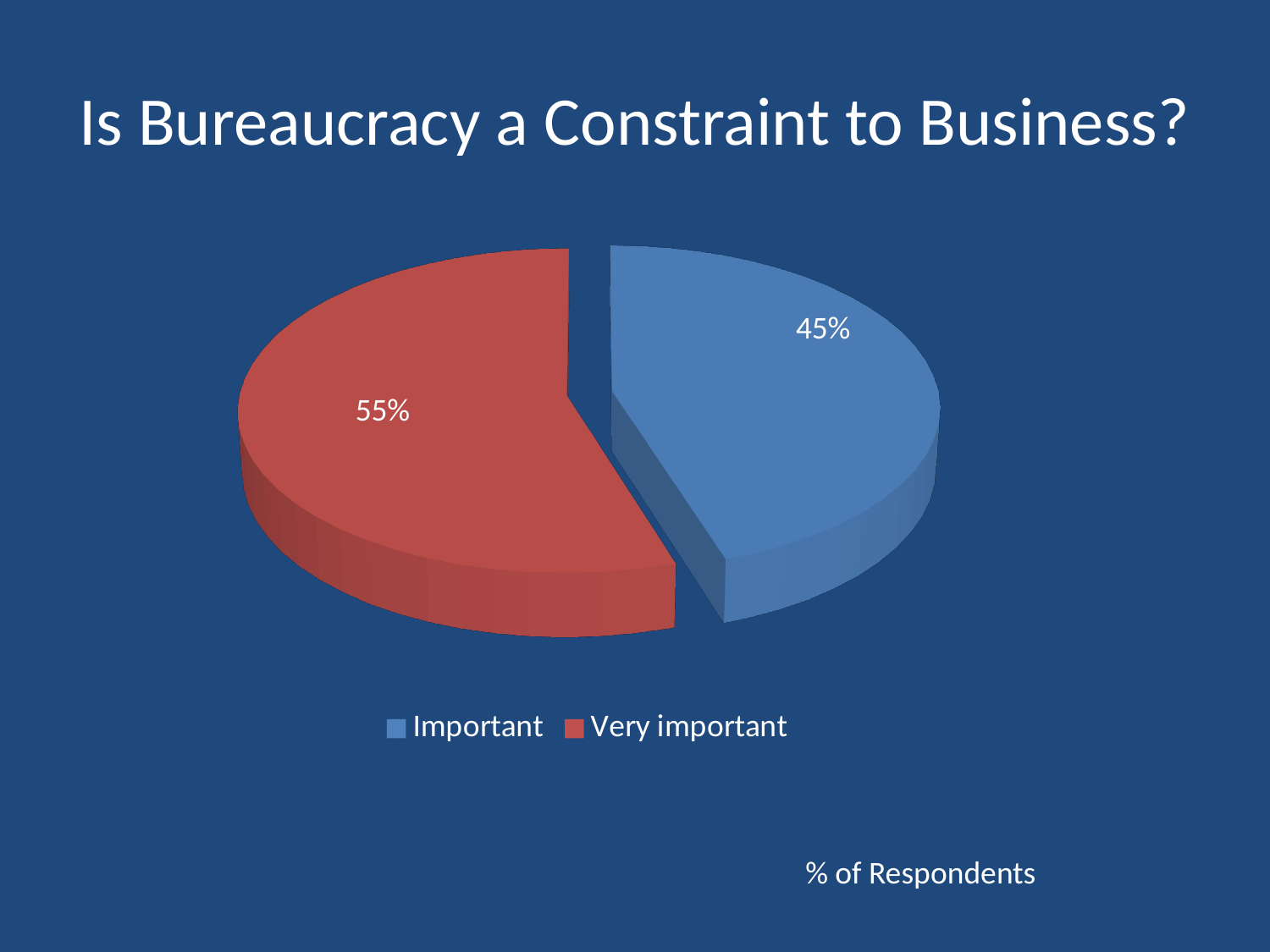
Which is larger: the share for "Important" or the share for "Very important"? Very important Which category has the largest share of the pie? Very important What is the difference in percentage points between "Very important" and "Important"? 10 What kind of chart is shown on the slide? Pie chart What is the title of the slide? Is Bureaucracy a Constraint to Business? What share of the pie does the "Very important" slice represent? 55% Which category has the smallest share of the pie? Important How many categories does the pie chart show? 2 Which colour represents the "Important" category in the legend? Blue What percentage of respondents rated bureaucracy as "Important"? 45% What percentage of respondents rated bureaucracy as "Very important"? 55%